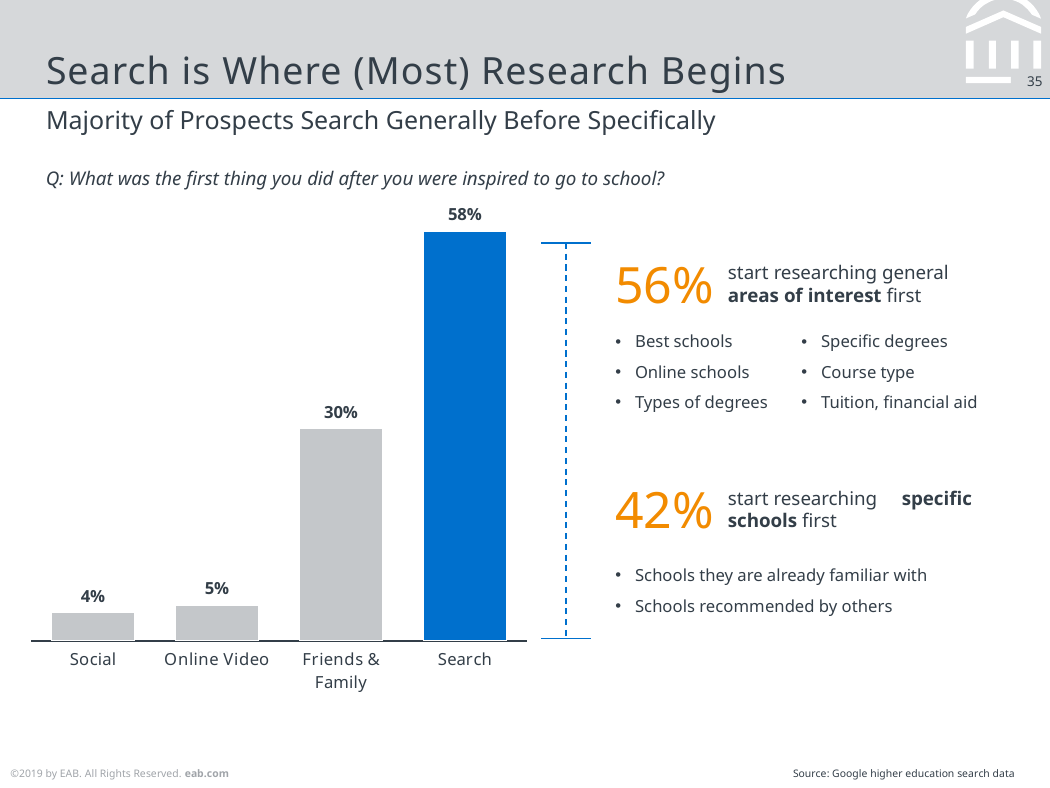
What is the value for Online Video? 5% What is the difference between the values for Search and Friends & Family? 28% What kind of chart is shown on the slide? Bar chart What is the value for Social? 4% What is the value for Friends & Family? 30% Which bar is coloured blue rather than grey? Search Which category has the lowest value? Social What is the difference between the values for Online Video and Social? 1% What is the value for Search? 58% How many categories are shown in the chart? 4 Which is larger, the value for Friends & Family or the value for Online Video? Friends & Family Which category has the highest value? Search